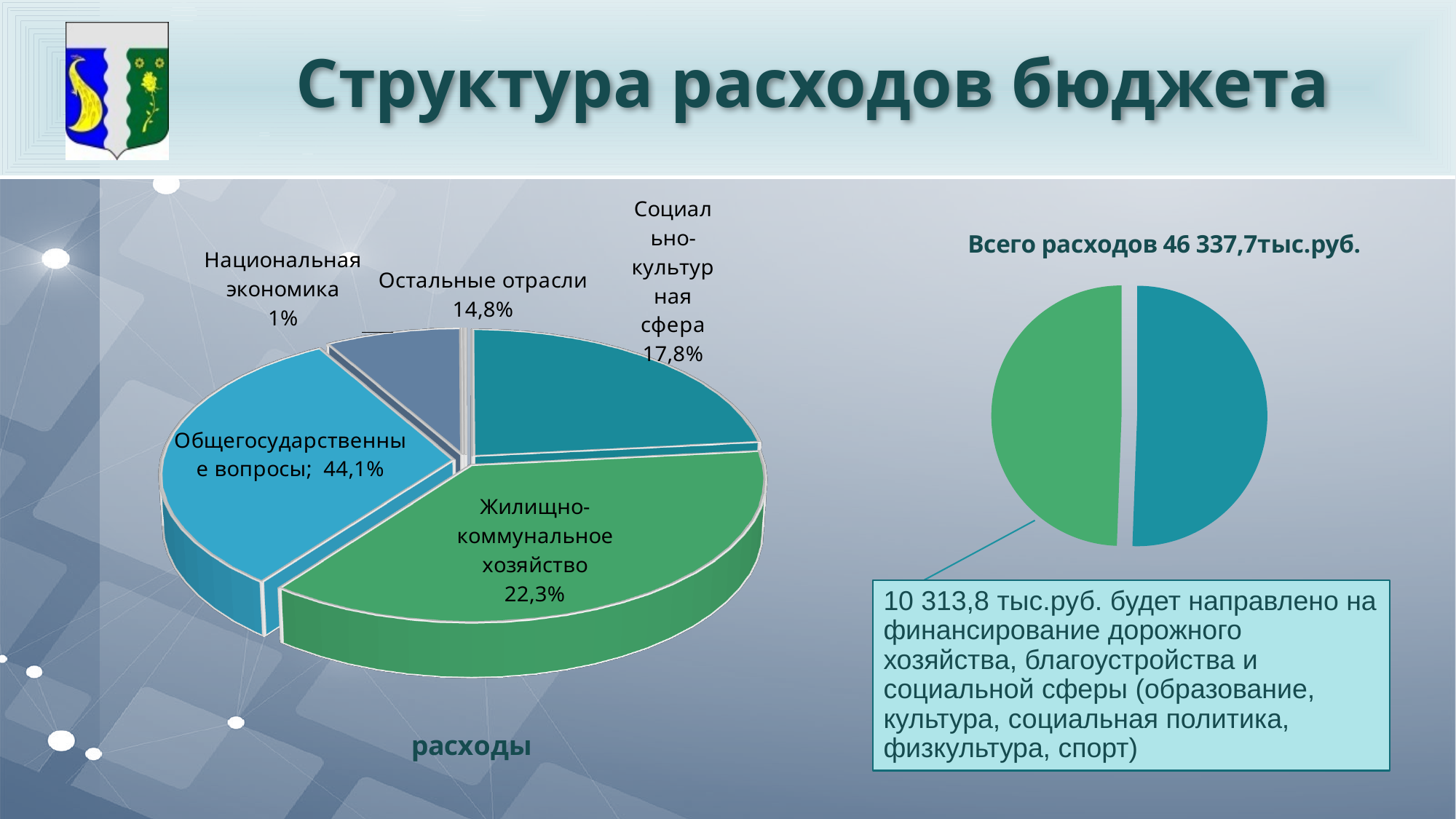
What total expenditure amount is stated in the title above the small pie chart on the right? 46 337,7тыс.руб. What kind of chart is the left chart titled "расходы"? Pie chart On the left pie chart titled "расходы", what share is shown for Социально-культурная сфера? 17,8% On the left pie chart titled "расходы", what is the difference in percentage points between Общегосударственные вопросы and Жилищно-коммунальное хозяйство? 21,8 On the left pie chart titled "расходы", which category has the largest share? Общегосударственные вопросы On the left pie chart titled "расходы", what share is shown for Остальные отрасли? 14,8% On the left pie chart titled "расходы", which category has the smallest share? Национальная экономика On the left pie chart titled "расходы", which is larger: Социально-культурная сфера or Остальные отрасли? Социально-культурная сфера On the left pie chart titled "расходы", what share is shown for Общегосударственные вопросы? 44,1% On the left pie chart titled "расходы", what share is shown for Жилищно-коммунальное хозяйство? 22,3% How many slices does the left pie chart titled "расходы" have? 5 How many slices does the small pie chart on the right of the slide have? 2